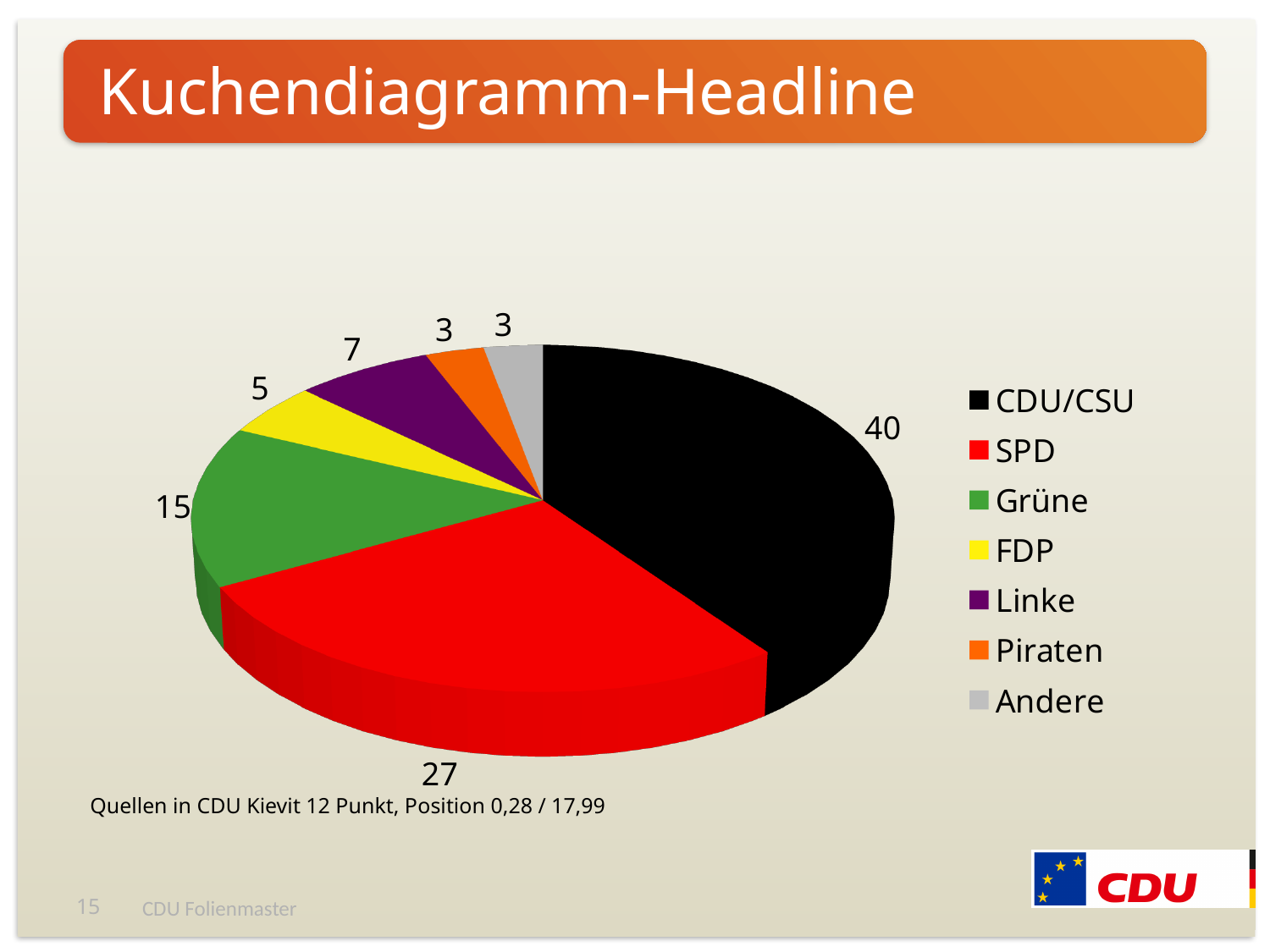
What value is shown for CDU/CSU in the pie chart? 40 How many categories does the pie chart show? 7 What value is shown for Grüne in the pie chart? 15 What value is shown for Linke in the pie chart? 7 What is the difference between the values for Grüne and FDP? 10 What is the difference between the values for CDU/CSU and SPD? 13 What kind of chart is shown on the slide? Pie chart What is the title of the chart on the slide? Kuchendiagramm-Headline Which is larger, the value for Linke or the value for FDP? Linke Which category has the largest slice in the pie chart? CDU/CSU What value is shown for SPD in the pie chart? 27 What share of the pie does the CDU/CSU slice represent? 40%